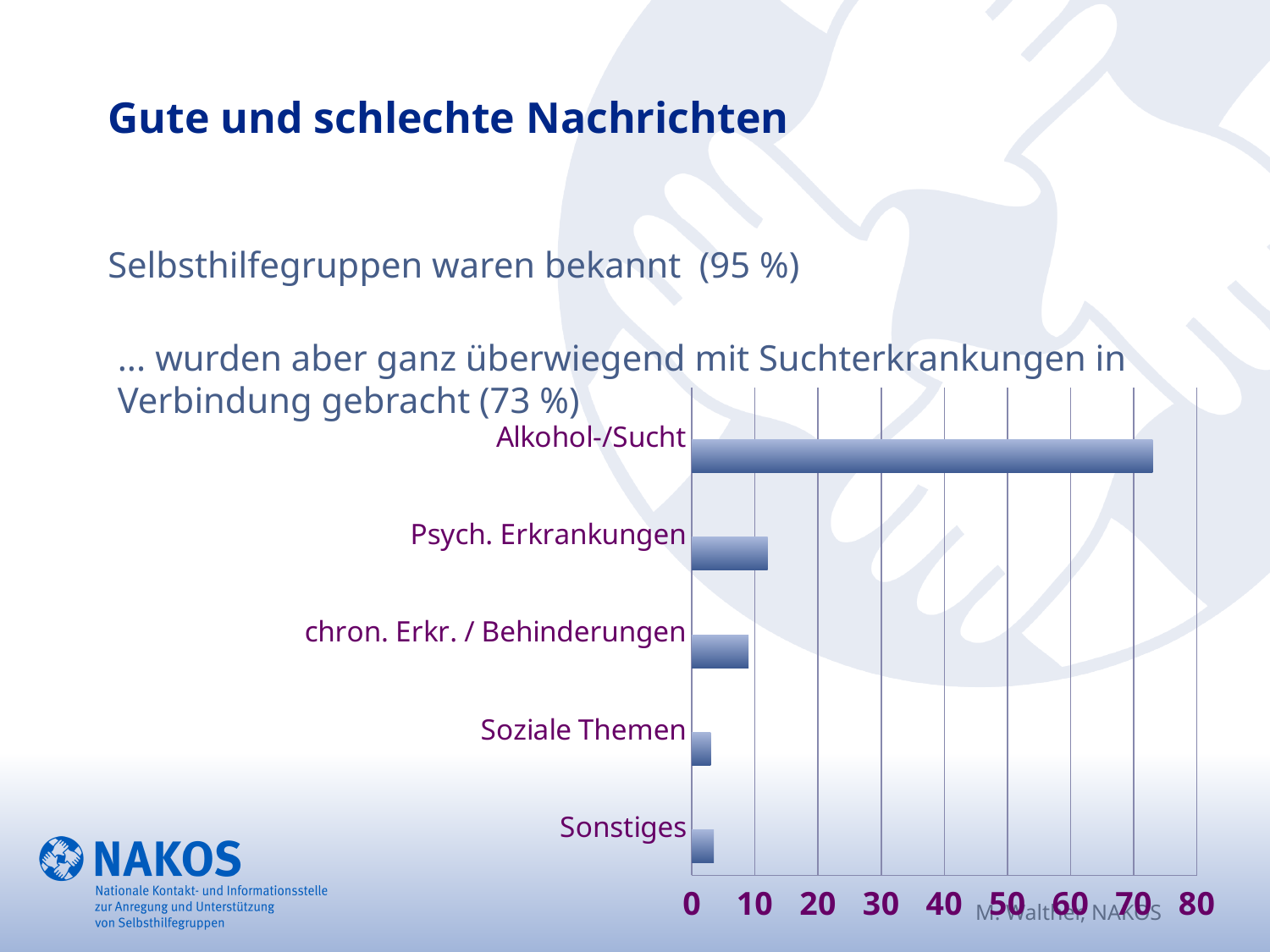
Which has the larger value, Alkohol-/Sucht or Psych. Erkrankungen? Alkohol-/Sucht Is the value for Soziale Themen greater or less than 10? less Which has the larger value, Psych. Erkrankungen or chron. Erkr. / Behinderungen? Psych. Erkrankungen Which category is listed at the top of the bar chart? Alkohol-/Sucht Is the value for Psych. Erkrankungen greater or less than 10? greater Is the value for Alkohol-/Sucht greater or less than 80? less How many categories does the bar chart show? 5 What is the highest value shown on the chart's horizontal axis? 80 Which category has the highest value in the bar chart? Alkohol-/Sucht What kind of chart is shown on the slide? bar chart